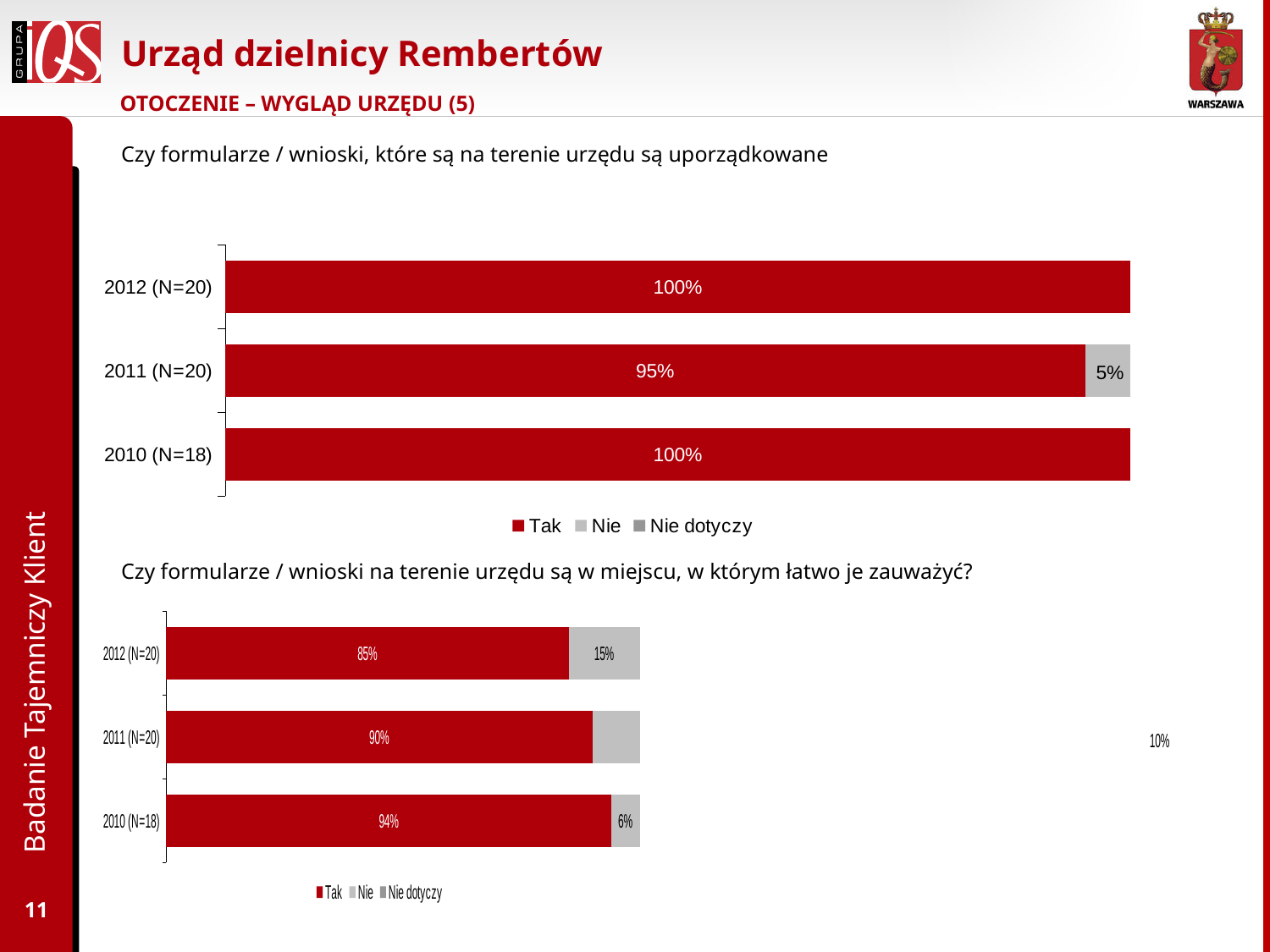
In the top chart ("Czy formularze / wnioski, które są na terenie urzędu są uporządkowane"), what is the Tak value for 2011 (N=20)? 95% In the bottom chart, what is the difference between the Tak values for 2010 (N=18) and 2012 (N=20)? 9% In the top chart, what is the Tak value for 2012 (N=20)? 100% In the top chart, how many series does the legend list? 3 In the bottom chart, what is the Nie value for 2010 (N=18)? 6% What type of chart is the top chart? Stacked bar chart In the bottom chart, is the Tak value for 2011 (N=20) larger or smaller than the Tak value for 2012 (N=20)? larger In the bottom chart, which year has the highest Tak value? 2010 (N=18) In the top chart, which year has the lowest Tak value? 2011 (N=20) In the bottom chart, how many year categories are shown? 3 In the bottom chart ("Czy formularze / wnioski na terenie urzędu są w miejscu, w którym łatwo je zauważyć?"), what is the Tak value for 2012 (N=20)? 85% In the top chart, what is the Nie value for 2011 (N=20)? 5%